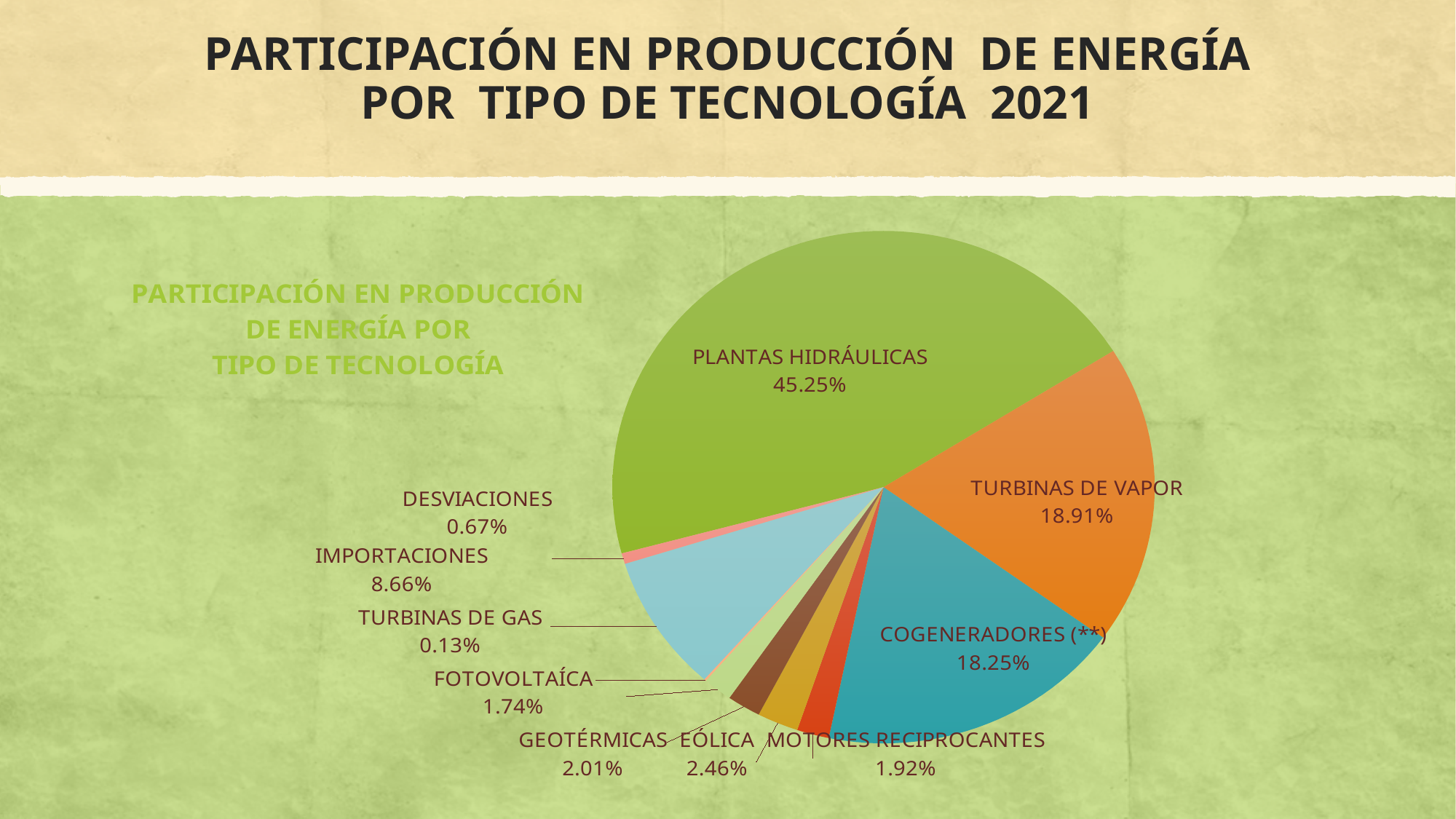
What percentage is shown for IMPORTACIONES? 8.66% Which category has the smallest share of the pie? TURBINAS DE GAS What is the value for TURBINAS DE GAS? 0.13% What type of chart is shown on the slide? Pie chart Which category has the largest share of the pie? PLANTAS HIDRÁULICAS What is the combined share of FOTOVOLTAÍCA and MOTORES RECIPROCANTES? 3.66% Which has a larger share, EÓLICA or GEOTÉRMICAS? EÓLICA What share of energy production does PLANTAS HIDRÁULICAS have? 45.25% How many categories are shown in the pie chart? 10 What is the difference between the shares of TURBINAS DE VAPOR and COGENERADORES (**)? 0.66% What is the title of the chart? PARTICIPACIÓN EN PRODUCCIÓN DE ENERGÍA POR TIPO DE TECNOLOGÍA What is the value shown for TURBINAS DE VAPOR? 18.91%